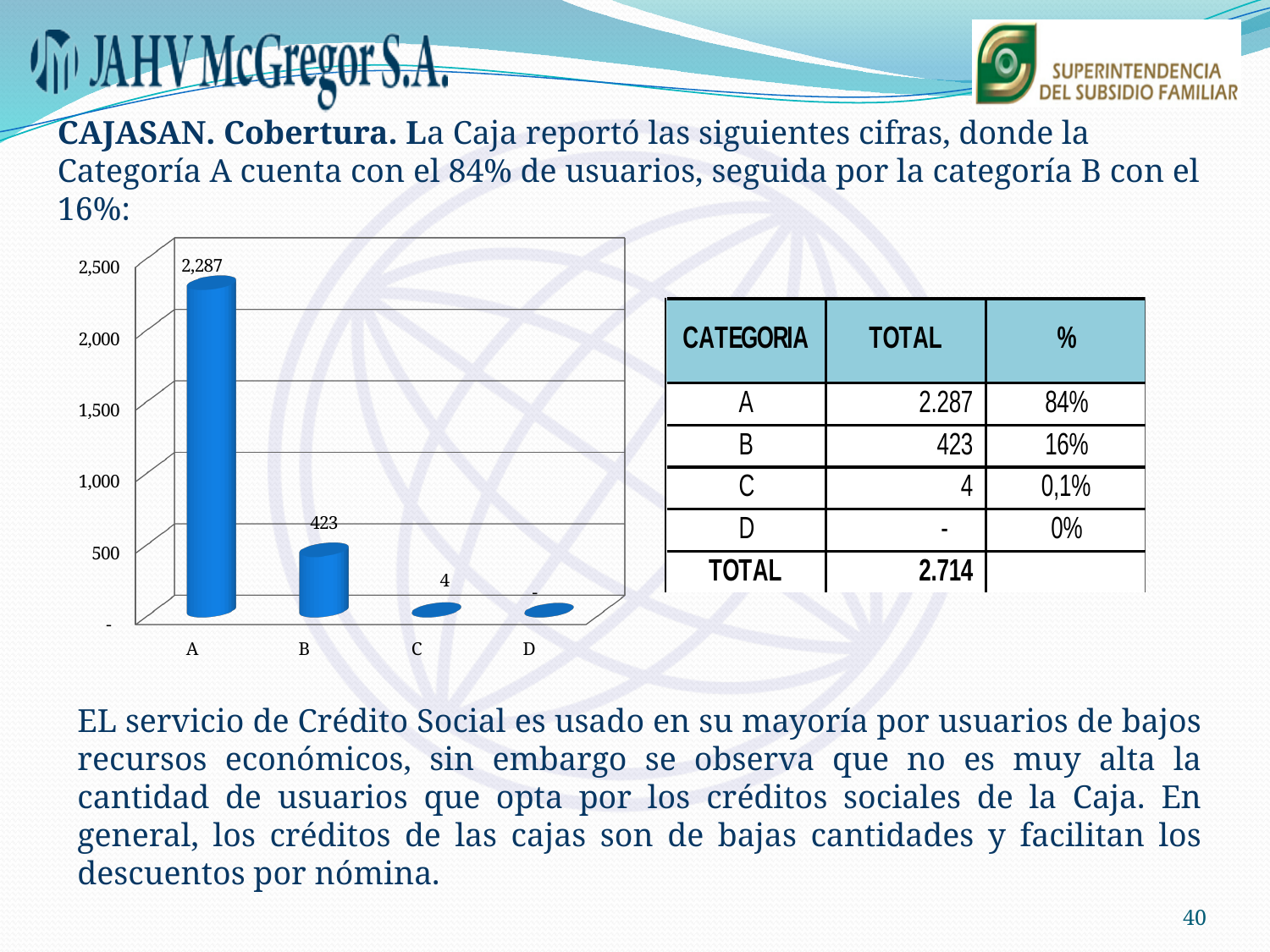
What value is shown for category C in the bar chart? 4 Which category has the highest value in the bar chart? A What value is shown for category B in the bar chart? 423 Which category has the lowest value in the bar chart? D What kind of chart is shown on the slide? bar chart How many categories are shown on the x axis of the bar chart? 4 Is the value for category A in the bar chart greater or less than 2,000? greater What is the difference between the values for categories A and B in the bar chart? 1,864 What value is shown for category A in the bar chart? 2,287 Do the values in the bar chart rise or fall from category A to category D? fall Is the value for category B in the bar chart greater or less than 500? less Which is larger in the bar chart, the value for category B or the value for category C? B